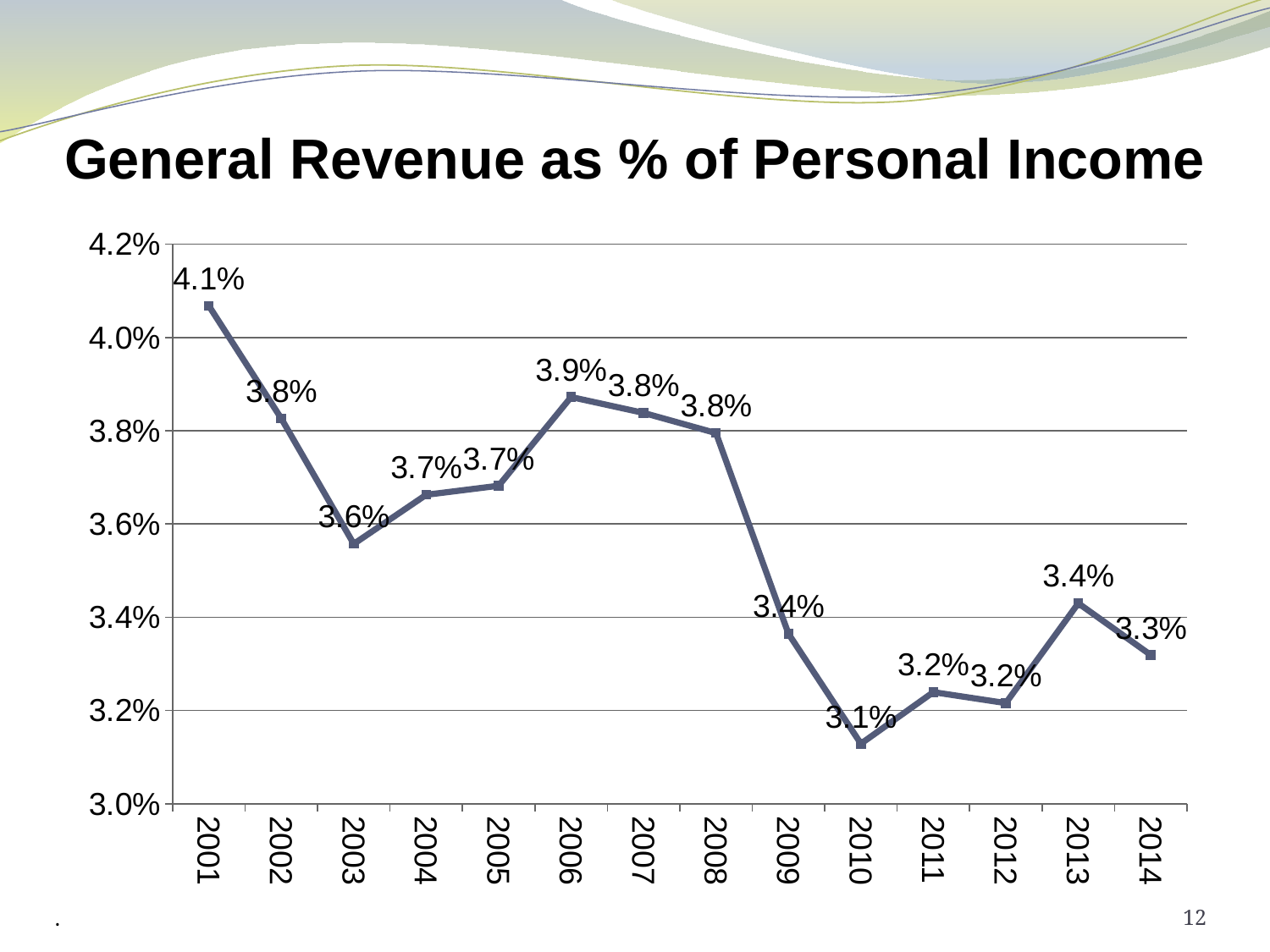
Which year has the lowest value? 2010 What is the value for 2014? 3.3% How many years are plotted on the x axis? 14 Is the value for 2009 greater or less than 3.6%? less What is the title of the chart? General Revenue as % of Personal Income Which is larger, the value for 2006 or the value for 2009? 2006 What is the difference between the values for 2001 and 2010? 1.0 percentage points Which year has the highest value? 2001 What is the value for 2010? 3.1% What is the value for 2001? 4.1% What is the value for 2006? 3.9% What kind of chart is shown? line chart